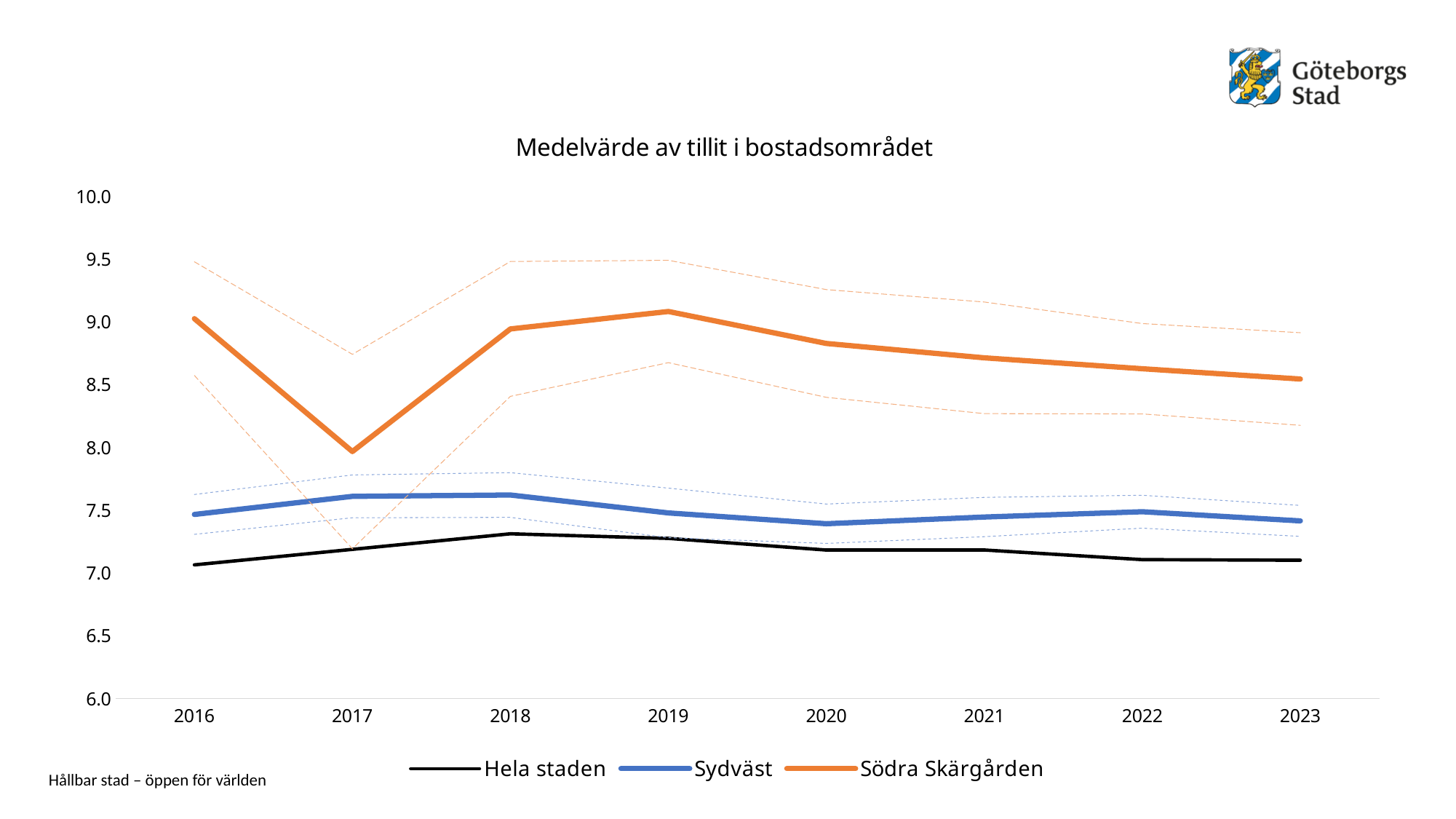
In which year is the value for Södra Skärgården lowest? 2017 Which is larger in 2016, the value for Sydväst or the value for Södra Skärgården? Södra Skärgården Is the value for Södra Skärgården in 2016 greater or less than 8.5? greater What is the title of the chart? Medelvärde av tillit i bostadsområdet How many years are shown on the x axis? 8 Is the value for Hela staden in 2016 greater or less than 7.5? less Which series has the highest value in 2023? Södra Skärgården Does the value for Hela staden rise or fall from 2016 to 2018? rise Is the value for Sydväst in 2018 greater or less than 7.5? greater Which series has the lowest value in 2019? Hela staden What kind of chart is shown on the slide? line chart How many series does the legend list? 3